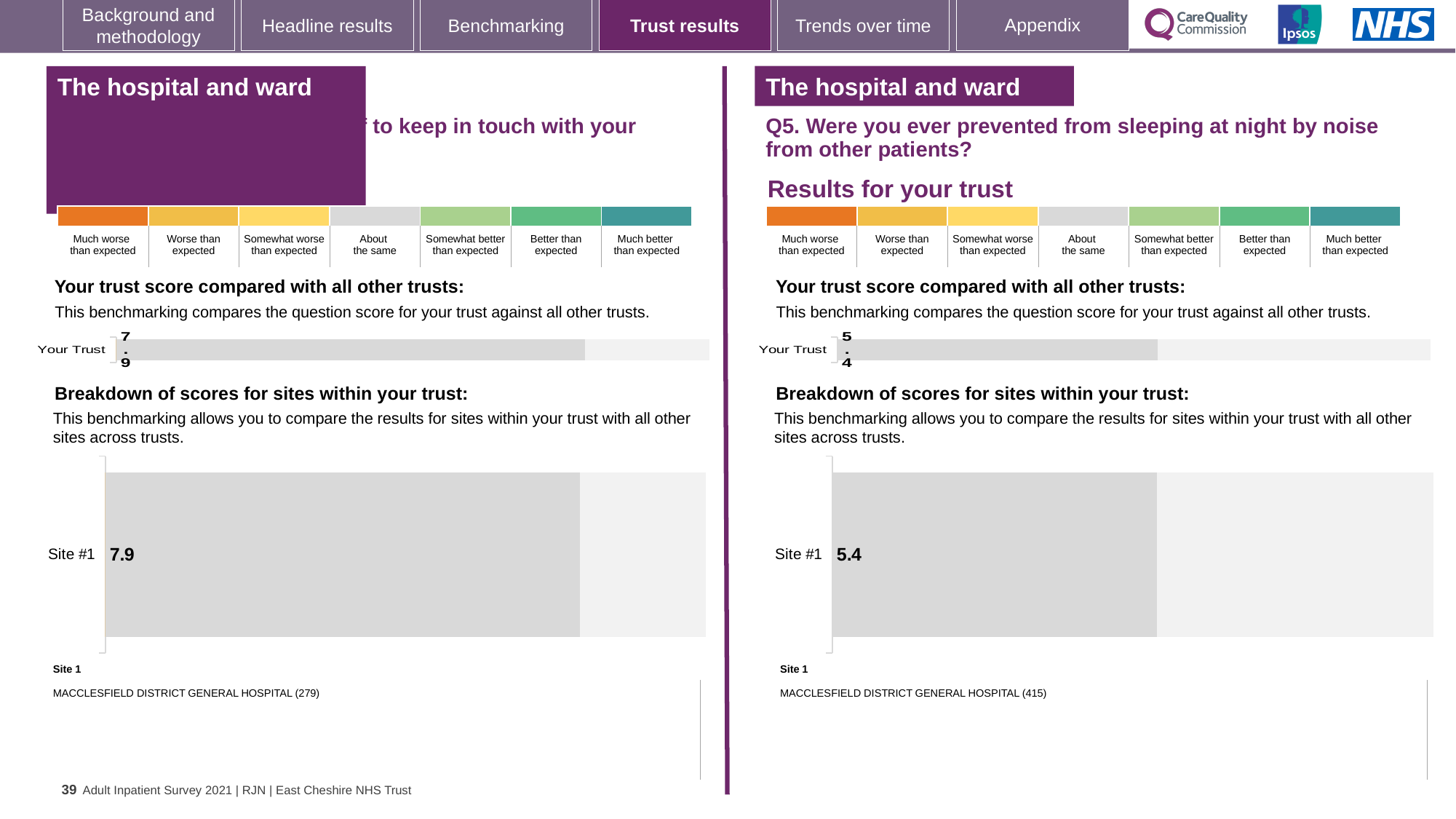
On the right-hand side of the slide (Q5), what score is shown for Site #1 in the breakdown of scores for sites within your trust? 5.4 Is the Your Trust score on the right-hand side of the slide (Q5) greater or less than the Your Trust score on the left-hand side? less How many sites are shown in the breakdown of scores chart on the left-hand side of the slide? 1 How many sites are shown in the breakdown of scores chart on the right-hand side of the slide (Q5)? 1 Which is larger: the Site #1 score on the left-hand side of the slide or the Site #1 score on the right-hand side (Q5)? Left-hand side (7.9) How many categories does the colour key above the charts list, from 'Much worse than expected' to 'Much better than expected'? 7 On the right-hand side of the slide (Q5, prevented from sleeping at night by noise), what is the score shown for Your Trust? 5.4 What is the difference between the Site #1 score on the left-hand side of the slide (7.9) and the Site #1 score on the right-hand side (5.4)? 2.5 On the left-hand side of the slide, what score is shown for Site #1 in the breakdown of scores for sites within your trust? 7.9 On the left-hand side of the slide, what is the score shown for Your Trust? 7.9 Which site name is listed as Site 1 on the right-hand side of the slide (Q5)? MACCLESFIELD DISTRICT GENERAL HOSPITAL (415) What type of chart is used to show the Site #1 score on the right-hand side of the slide (Q5)? Bar chart